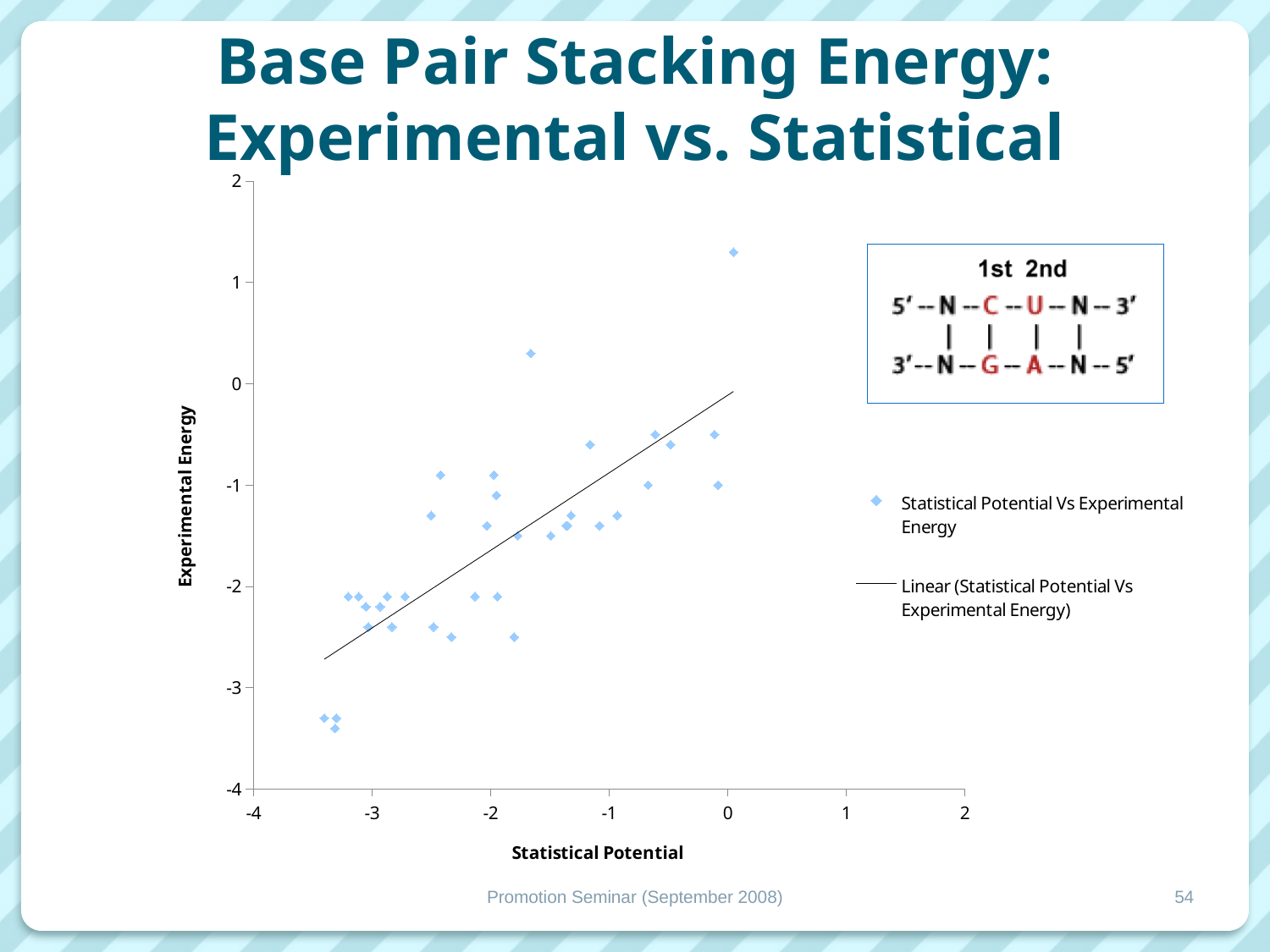
What is the title of the x axis? Statistical Potential What kind of chart is shown on the slide? scatter chart How many entries does the chart legend list? 2 Is the lowest plotted Experimental Energy value greater or less than -3? less As Statistical Potential increases along the x axis, does Experimental Energy generally rise or fall? rise What is the title of the y axis? Experimental Energy Is the highest plotted Experimental Energy value greater or less than 1? greater Does the linear trendline slope upward or downward from left to right? upward